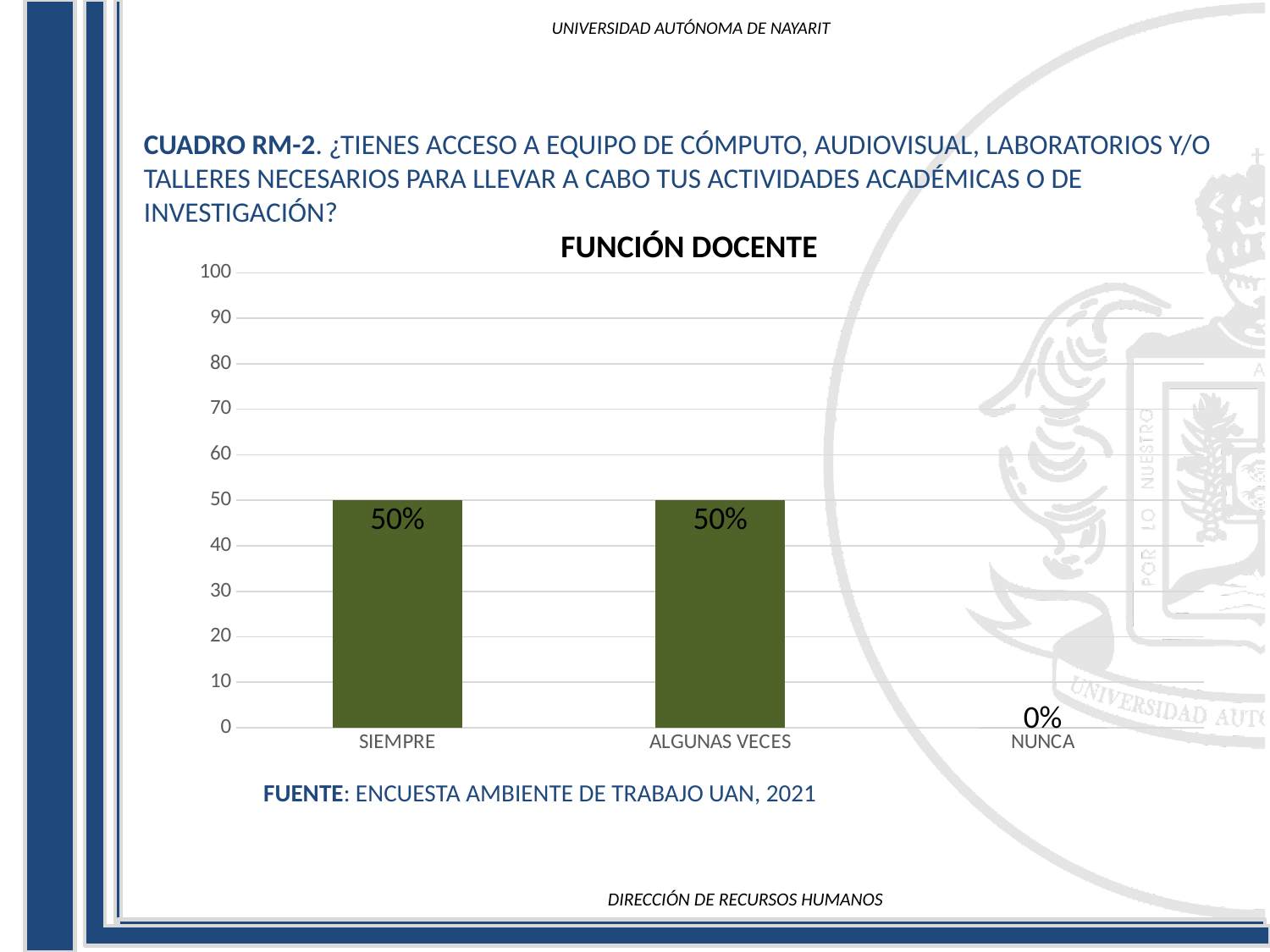
What kind of chart is shown on the slide? bar chart What is the value for ALGUNAS VECES? 50% How many categories are shown on the x axis? 3 Is the value for SIEMPRE greater or less than 40? greater What is the difference between the values for SIEMPRE and NUNCA? 50% What is the value for NUNCA? 0% What is the maximum value shown on the y axis? 100 Which is larger, the value for ALGUNAS VECES or the value for NUNCA? ALGUNAS VECES Is the value for ALGUNAS VECES greater or less than 60? less What is the value for SIEMPRE? 50% Which category has the lowest value? NUNCA What is the title of the chart? FUNCIÓN DOCENTE